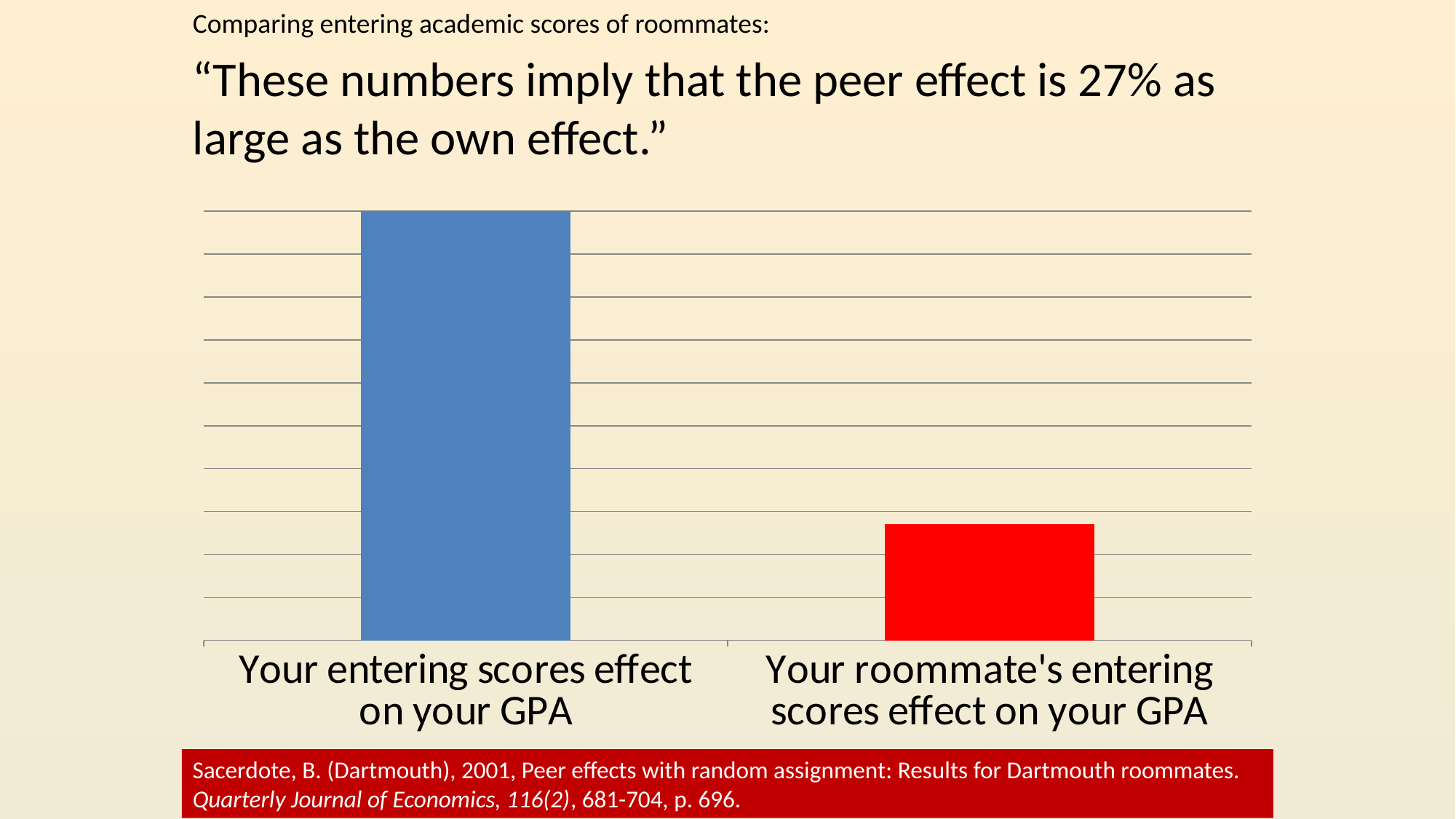
Which category has the shortest bar? Your roommate's entering scores effect on your GPA What colour is the bar for "Your entering scores effect on your GPA"? blue Is the bar for "Your roommate's entering scores effect on your GPA" taller or shorter than the bar for "Your entering scores effect on your GPA"? shorter What kind of chart is shown on the slide? bar chart Do the bar heights rise or fall from left to right across the chart? fall What colour is the bar for "Your roommate's entering scores effect on your GPA"? red Which category has the tallest bar? Your entering scores effect on your GPA How many bars are plotted in the chart? 2 Which is larger: the bar for "Your entering scores effect on your GPA" or the bar for "Your roommate's entering scores effect on your GPA"? Your entering scores effect on your GPA